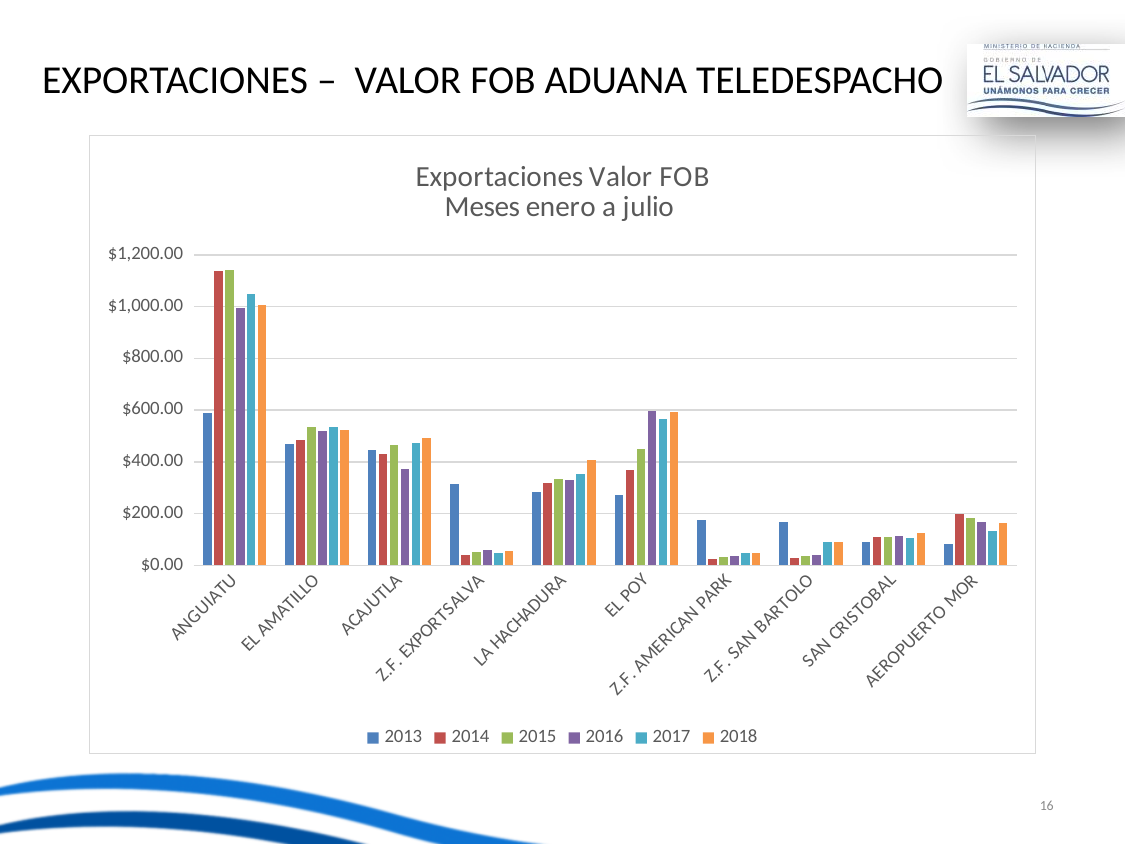
What is the title of the chart? Exportaciones Valor FOB Meses enero a julio How many customs offices (categories) are shown on the x axis of the chart? 10 Which category has the tallest bars in the chart? ANGUIATU How many series does the chart's legend list? 6 For EL POY, which is larger: the 2013 value or the 2016 value? 2016 Is the 2013 value for ANGUIATU greater or less than $800.00? less Is the 2014 value for ANGUIATU greater or less than $1,000.00? greater Is the 2013 value for Z.F. EXPORTSALVA greater or less than $200.00? greater For LA HACHADURA, which year has the highest value? 2018 For ANGUIATU, which year has the lowest value? 2013 What kind of chart is shown on the slide? bar chart For Z.F. EXPORTSALVA, which is larger: the 2013 value or the 2014 value? 2013